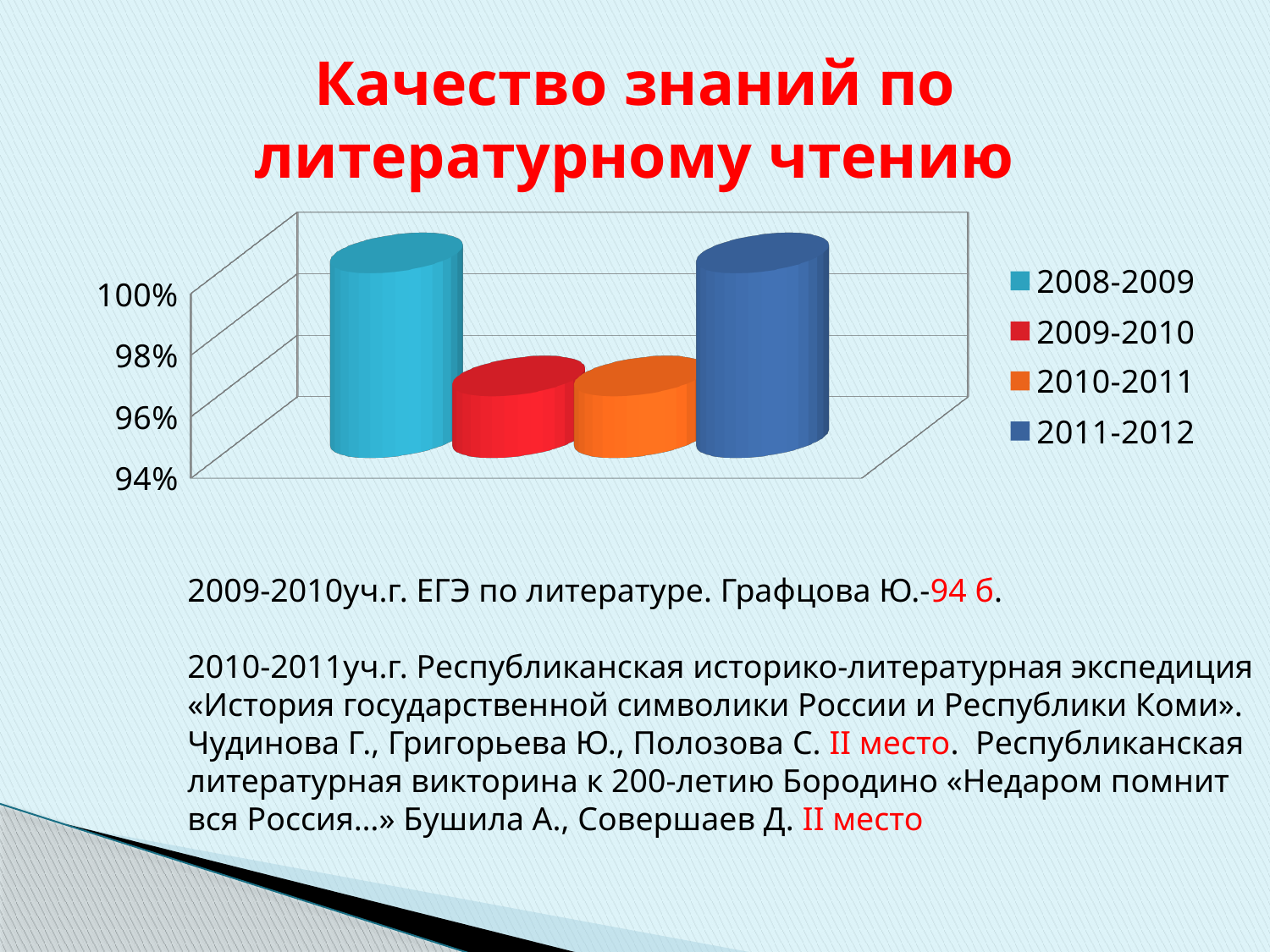
Which legend entry is shown in red? 2009-2010 Is the value for 2009-2010 greater or less than 98%? less Which is larger, the value for 2008-2009 or the value for 2009-2010? 2008-2009 Is the value for 2008-2009 greater or less than 98%? greater What is the lowest value shown on the vertical axis of the chart? 94% What is the title of the chart on the slide? Качество знаний по литературному чтению Which is larger, the value for 2010-2011 or the value for 2011-2012? 2011-2012 Is the value for 2010-2011 greater or less than 98%? less What kind of chart is shown on the slide? Bar chart How many bars are plotted in the chart? 4 How many series does the chart legend list? 4